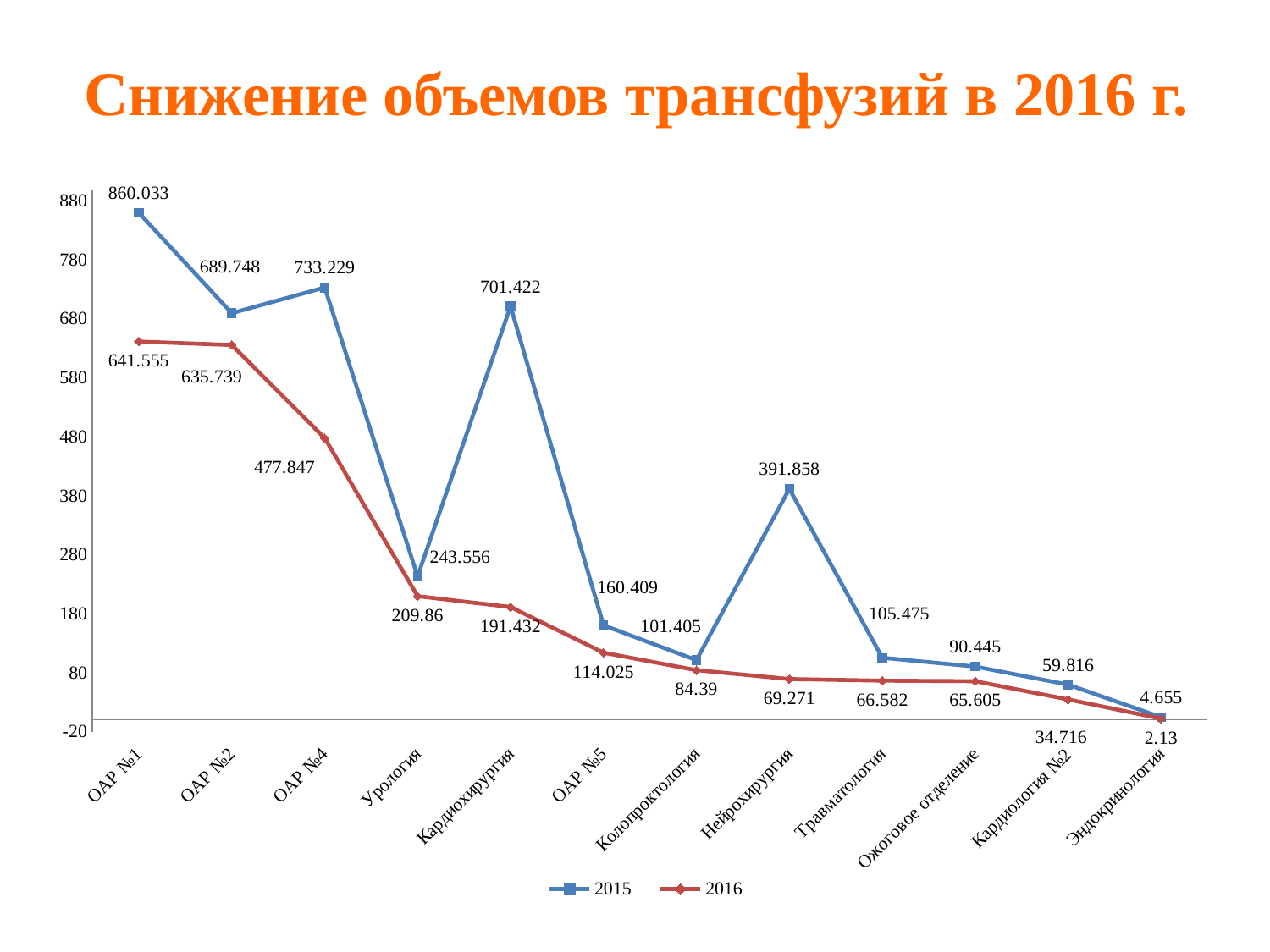
How many series does the legend list? 2 Does the 2016 line generally rise or fall from ОАР №1 to Эндокринология? fall How many departments (categories) are plotted along the x axis? 12 Which department has the lowest 2015 value? Эндокринология Which department has the highest 2016 value? ОАР №1 What is the 2015 value for Нейрохирургия? 391.858 What is the 2016 value for Кардиохирургия? 191.432 What type of chart is shown on the slide? line chart What is the title of the chart on the slide? Снижение объемов трансфузий в 2016 г. What is the difference between the 2015 and 2016 values for Кардиохирургия? 509.99 What is the 2015 value for ОАР №1? 860.033 Which is larger for ОАР №4: the 2015 value or the 2016 value? 2015